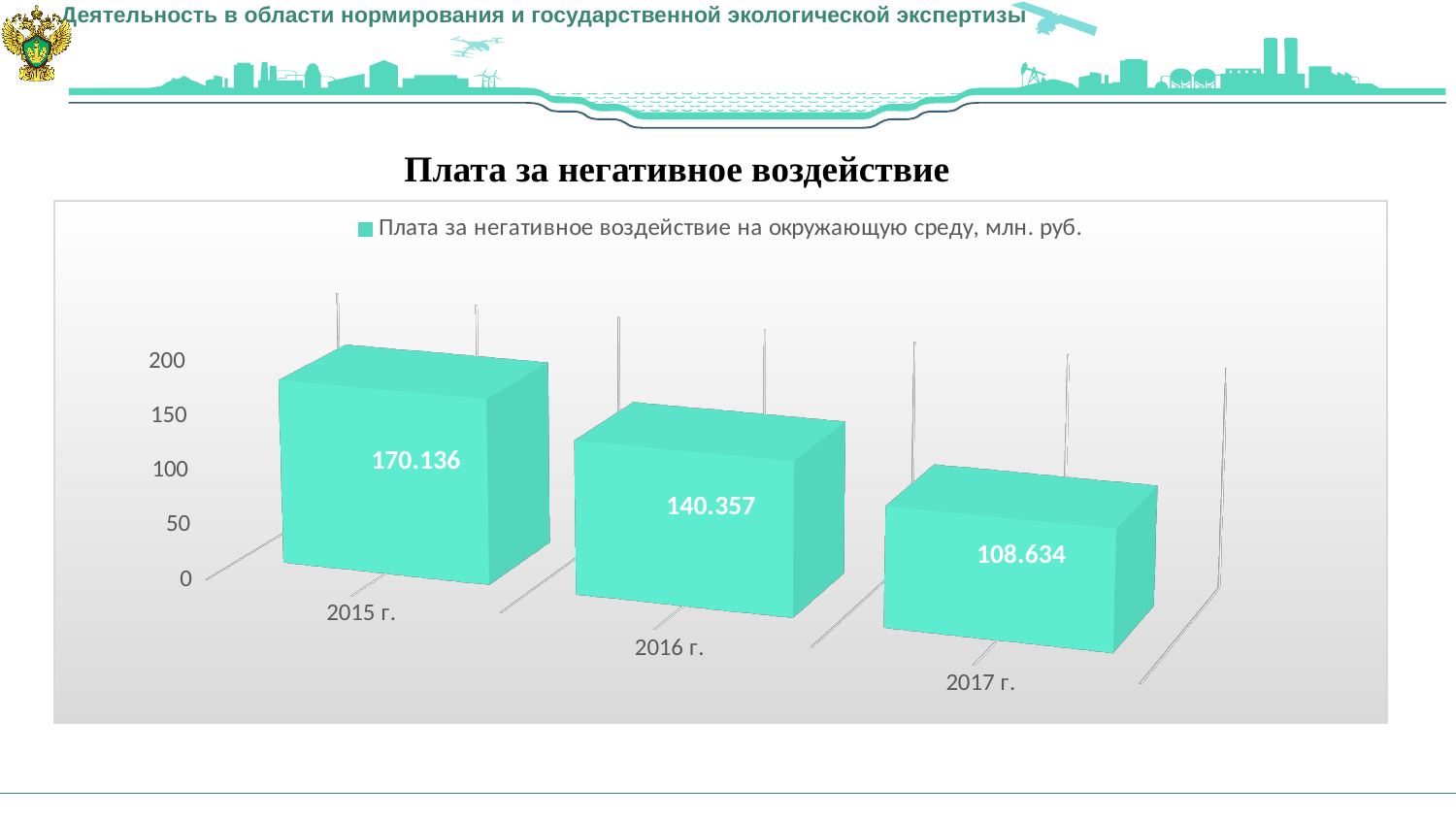
What is the value for 2016 г.? 140.357 Do the values rise or fall from 2015 г. to 2017 г.? fall Which is larger, the value for 2016 г. or the value for 2017 г.? 2016 г. What is the difference between the values for 2015 г. and 2016 г.? 29.779 How many years are shown on the x axis? 3 What is the value for 2017 г.? 108.634 What series name does the legend show? Плата за негативное воздействие на окружающую среду, млн. руб. What is the value for 2015 г.? 170.136 What is the difference between the values for 2016 г. and 2017 г.? 31.723 Which year has the lowest value? 2017 г. Which year has the highest value? 2015 г. What kind of chart is this? bar chart